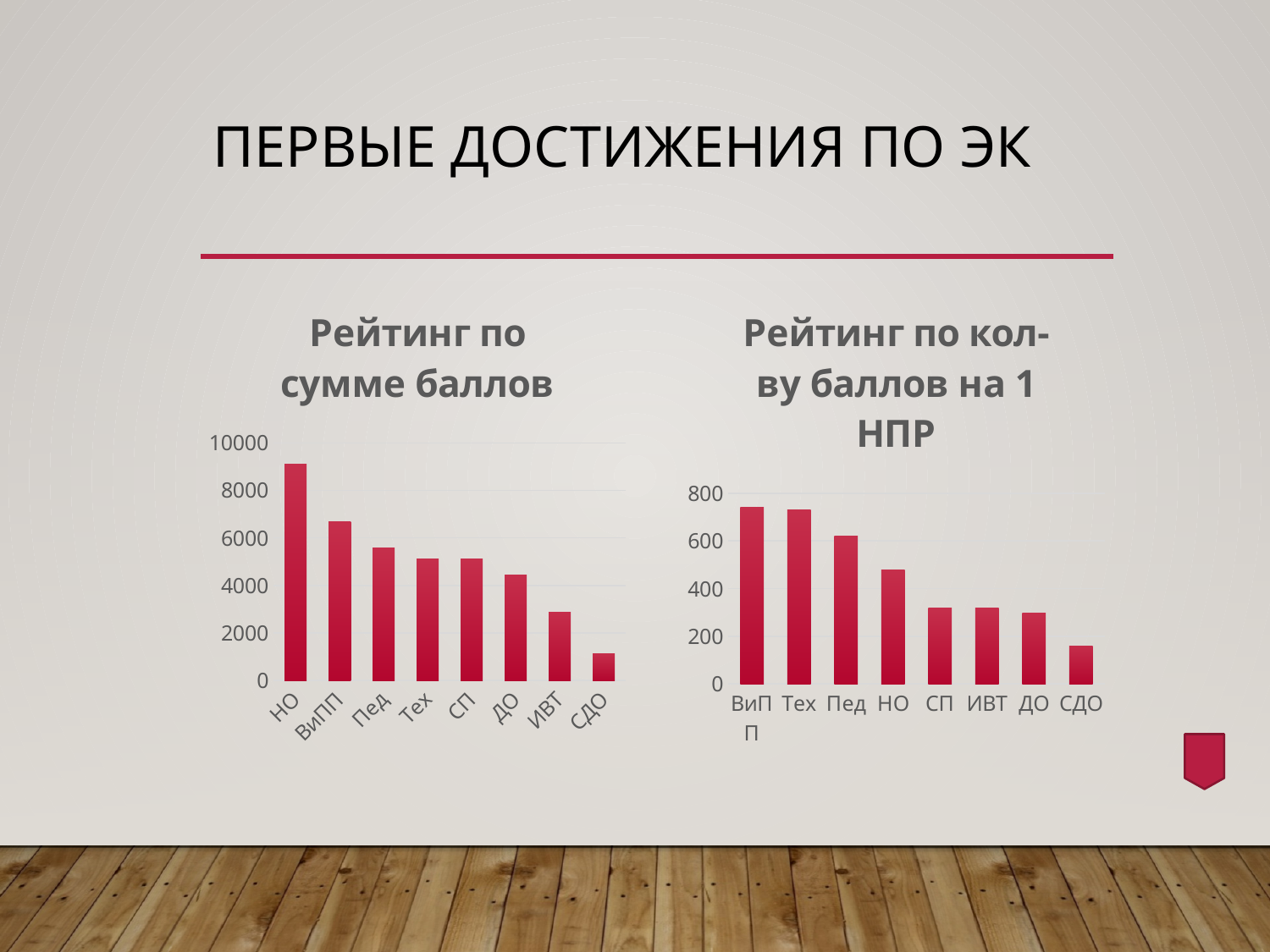
In the left chart "Рейтинг по сумме баллов", which category has the highest value? НО In the right chart "Рейтинг по кол-ву баллов на 1 НПР", which category has the lowest value? СДО In the right chart "Рейтинг по кол-ву баллов на 1 НПР", is the value for НО greater or less than 400? greater What kind of chart is the left chart titled "Рейтинг по сумме баллов"? bar chart In the left chart "Рейтинг по сумме баллов", is the value for НО greater or less than 8000? greater In the right chart "Рейтинг по кол-ву баллов на 1 НПР", is the value for СДО greater or less than 200? less In the right chart "Рейтинг по кол-ву баллов на 1 НПР", do the values rise or fall from left to right along the x axis? fall What is the title of the right chart on the slide? Рейтинг по кол-ву баллов на 1 НПР How many categories are shown in the left chart "Рейтинг по сумме баллов"? 8 In the left chart "Рейтинг по сумме баллов", which category has the lowest value? СДО In the left chart "Рейтинг по сумме баллов", which is larger, the value for ВиПП or the value for Пед? ВиПП